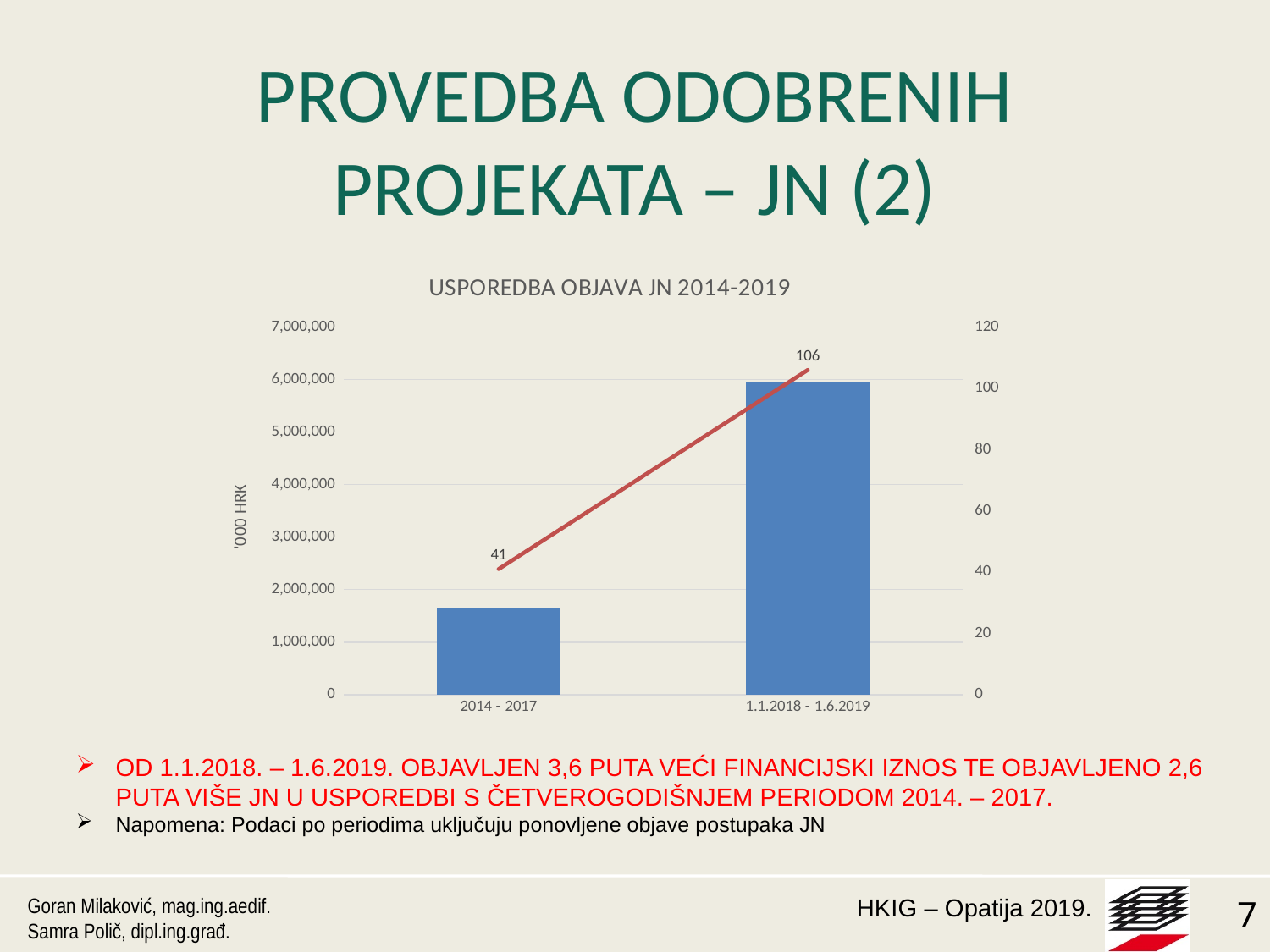
What is the value of the line marker for the 2014 - 2017 period? 41 What is the difference between the line values for 1.1.2018 - 1.6.2019 and 2014 - 2017? 65 What is the value of the line marker for the 1.1.2018 - 1.6.2019 period? 106 What is the label on the left vertical axis? '000 HRK Is the bar value for 2014 - 2017 greater or less than 2,000,000? less Do the values rise or fall from the 2014 - 2017 period to the 1.1.2018 - 1.6.2019 period? rise Which period has the lower bar? 2014 - 2017 How many periods (categories) are shown on the x axis? 2 Which period has the taller bar, 2014 - 2017 or 1.1.2018 - 1.6.2019? 1.1.2018 - 1.6.2019 What is the title of the chart? USPOREDBA OBJAVA JN 2014-2019 Which period has the higher line value? 1.1.2018 - 1.6.2019 Is the bar value for 1.1.2018 - 1.6.2019 greater or less than 5,000,000? greater